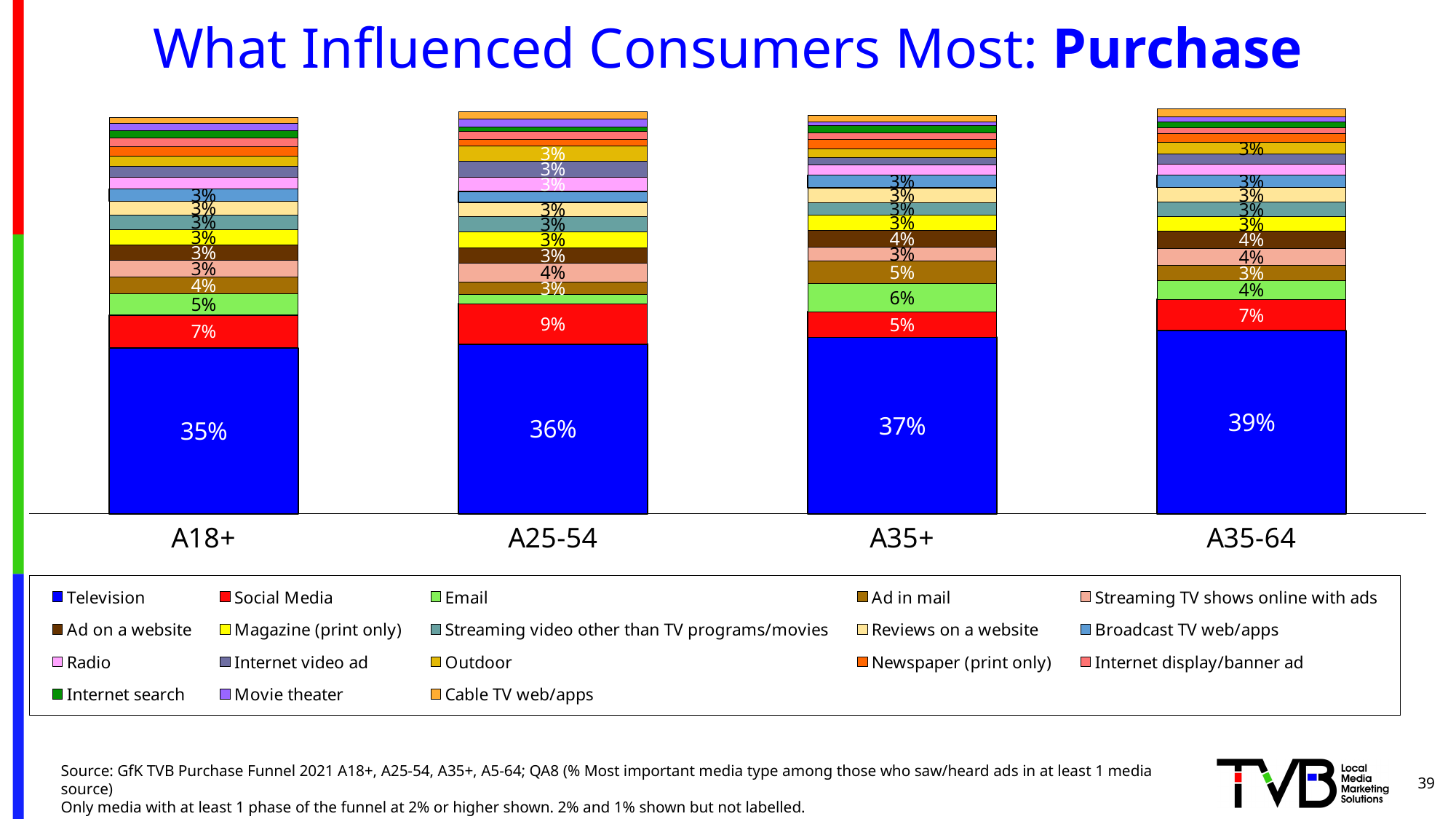
How many series does the legend list? 18 What is the Social Media value for A25-54? 9% What is the Ad in mail value for A35+? 5% What is the Email value for A35+? 6% What is the difference between the Television values for A35-64 and A18+? 4 percentage points What kind of chart is shown on the slide? Stacked bar chart How many age groups are shown on the x axis? 4 What is the Television value for A35-64? 39% Which age group has the highest Television value? A35-64 What is the Television value for A18+? 35% Which age group has the lowest Social Media value? A35+ Which has the larger Social Media value, A25-54 or A35+? A25-54